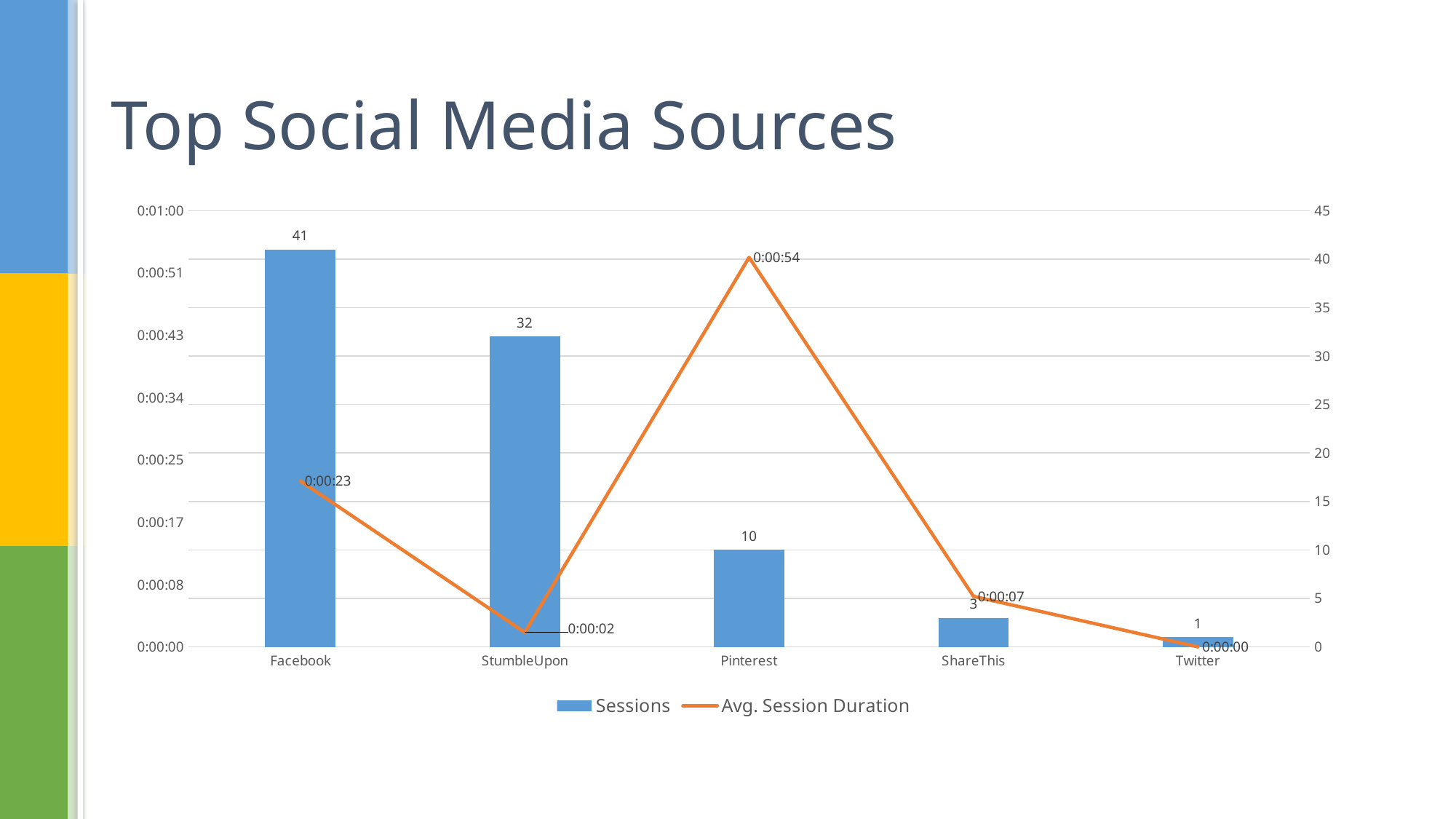
What is the average session duration for Pinterest? 0:00:54 How many sessions does the chart show for Facebook? 41 Which has more sessions, Pinterest or ShareThis? Pinterest How many series does the legend list? 2 How many sessions are shown for ShareThis? 3 What is the average session duration for StumbleUpon? 0:00:02 Which source has the highest number of sessions? Facebook What is the difference in sessions between Facebook and StumbleUpon? 9 How many social media sources are shown on the x axis? 5 What kind of chart is shown on the slide? A combined bar and line chart Which source has the longest average session duration? Pinterest Which source has the lowest number of sessions? Twitter